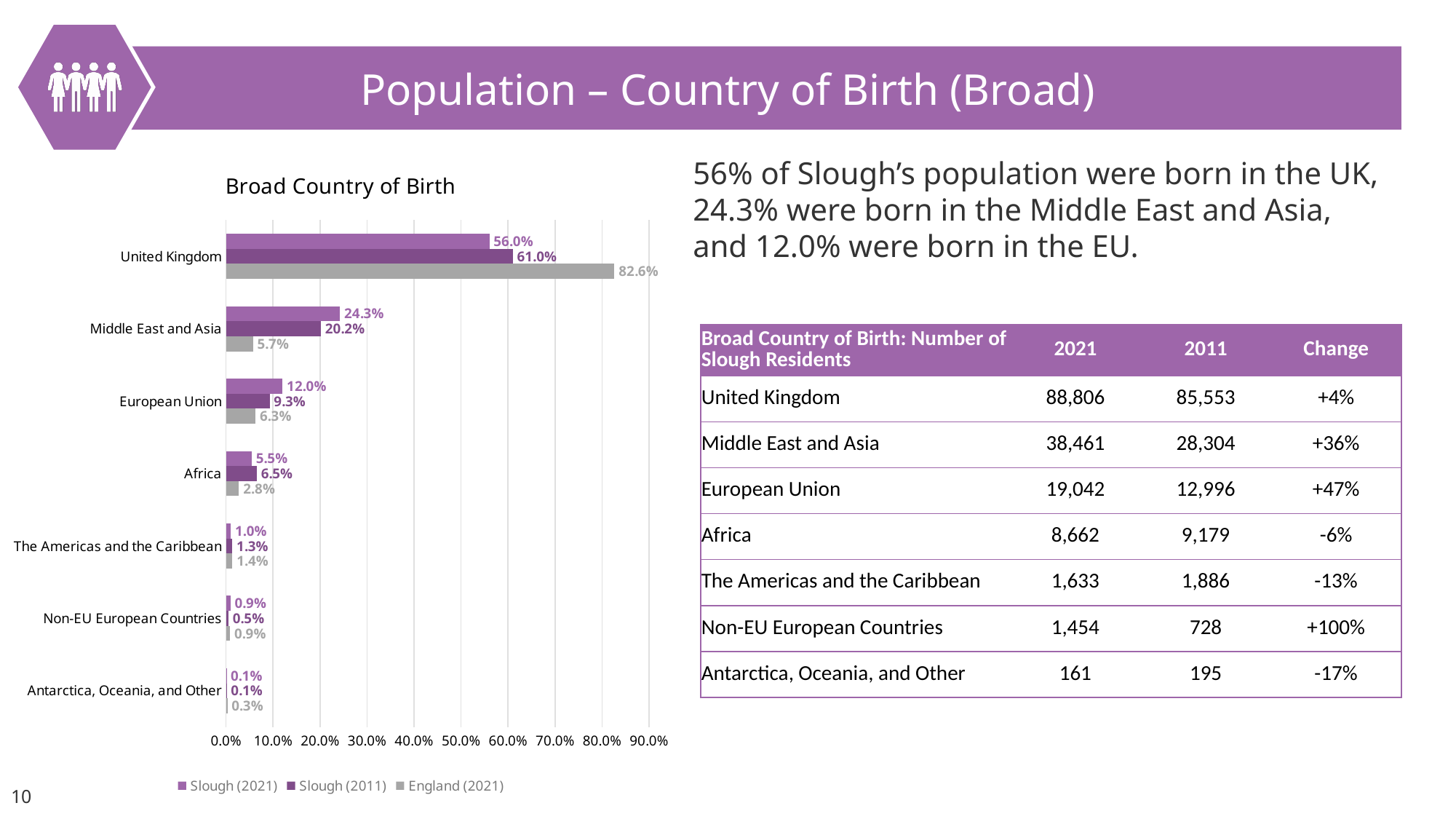
How many series does the legend list? 3 How many categories are shown on the chart? 7 Is the Slough (2011) value for the United Kingdom greater or less than 60.0%? greater What is the Slough (2011) value for the European Union? 9.3% Which category has the highest Slough (2021) value? United Kingdom What is the England (2021) value for Middle East and Asia? 5.7% Which is larger for Africa: the Slough (2021) value or the Slough (2011) value? Slough (2011) What is the title of the chart? Broad Country of Birth What is the difference between the England (2021) and Slough (2021) values for the United Kingdom? 26.6% Which category has the lowest England (2021) value? Antarctica, Oceania, and Other What is the Slough (2021) value for the United Kingdom? 56.0% What kind of chart is shown on the slide? Bar chart